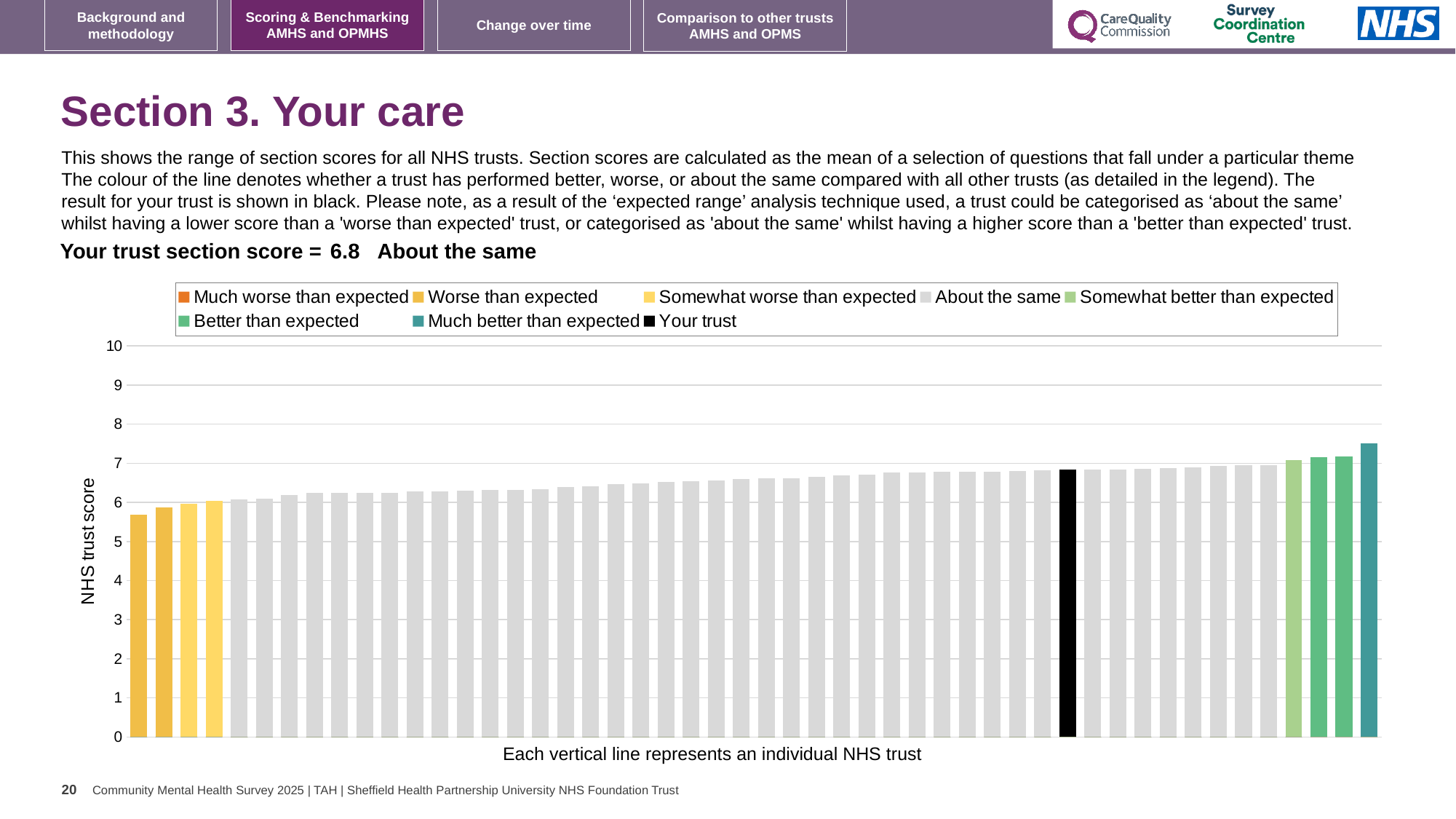
Do the bar values rise or fall from left to right along the x axis? rise How many entries does the chart legend list? 8 What colour does the legend use for 'Your trust'? black What kind of chart is shown on the slide? bar chart Is the value of the highest bar in the chart greater or less than 7? greater Is the value of the lowest bar in the chart greater or less than 6? less Which category is your trust placed in for this section? About the same How many bars are coloured as 'Much better than expected'? 1 Which is larger, the black bar for your trust or the teal bar at the far right? the teal bar at the far right Is the value for your trust (the black bar) greater or less than 7? less What is the section score for your trust shown on the slide? 6.8 What is the title of the vertical axis? NHS trust score